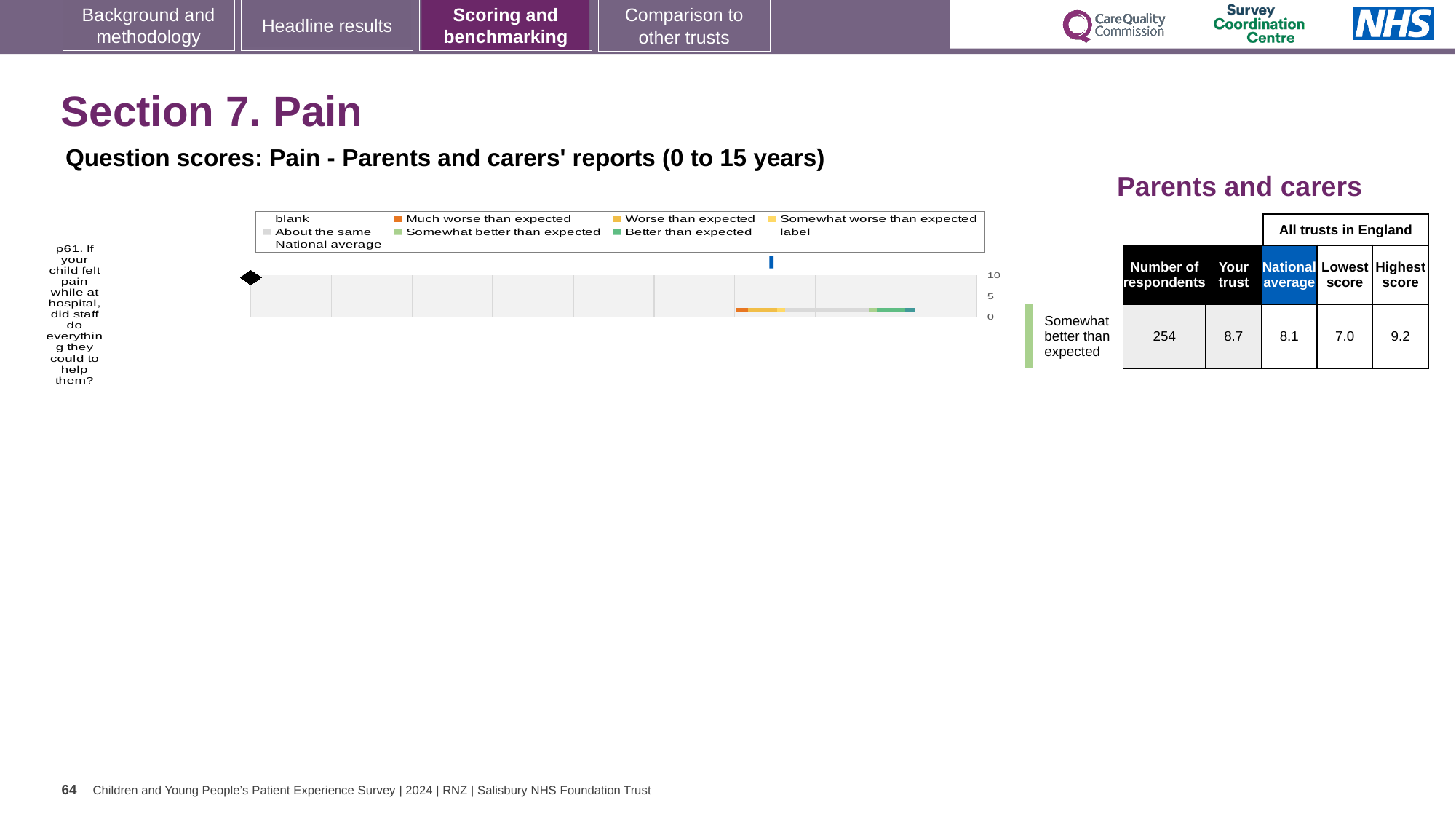
Which is larger for p61, the 'Your trust' score or the national average? Your trust What is the national average score for p61 in the Parents and carers table? 8.1 How many survey questions are plotted on the chart? 1 Which legend entry is shown in orange? Much worse than expected Is the national average marker for p61 positioned greater or less than 5 on the score axis? greater What is the lowest score among all trusts in England for p61? 7.0 What is the highest value shown on the chart's score axis? 10 What is the difference between the highest score and the lowest score for p61 across all trusts in England? 2.2 What is the 'Your trust' score for p61 in the Parents and carers table? 8.7 What kind of chart is used to show the p61 question score? bar chart How many respondents answered p61 according to the table? 254 What is the highest score among all trusts in England for p61? 9.2